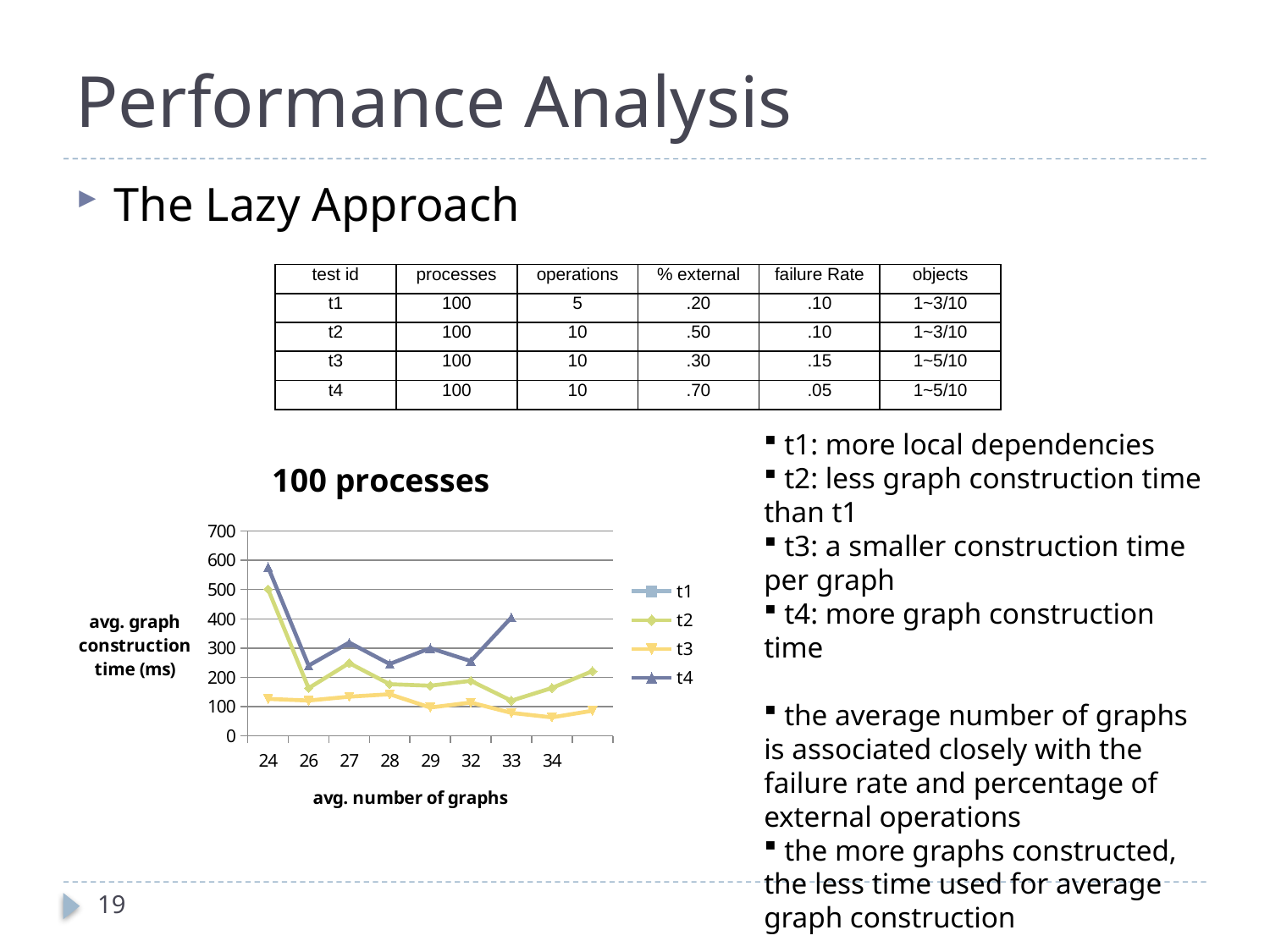
At 24 graphs, which series has the larger value, t2 or t4? t4 Does the t4 series rise or fall between 24 and 26 graphs? fall How many series does the chart legend list? 4 What kind of chart is shown on the slide? line chart At 33 graphs, which series has the larger value, t2 or t3? t2 What is the label of the x axis of the chart? avg. number of graphs Is the value for t4 at 26 graphs greater or less than 300? less Is the value for t4 at 24 graphs greater or less than 500? greater Is the value for t2 at 27 graphs greater or less than 200? greater What is the title of the chart? 100 processes